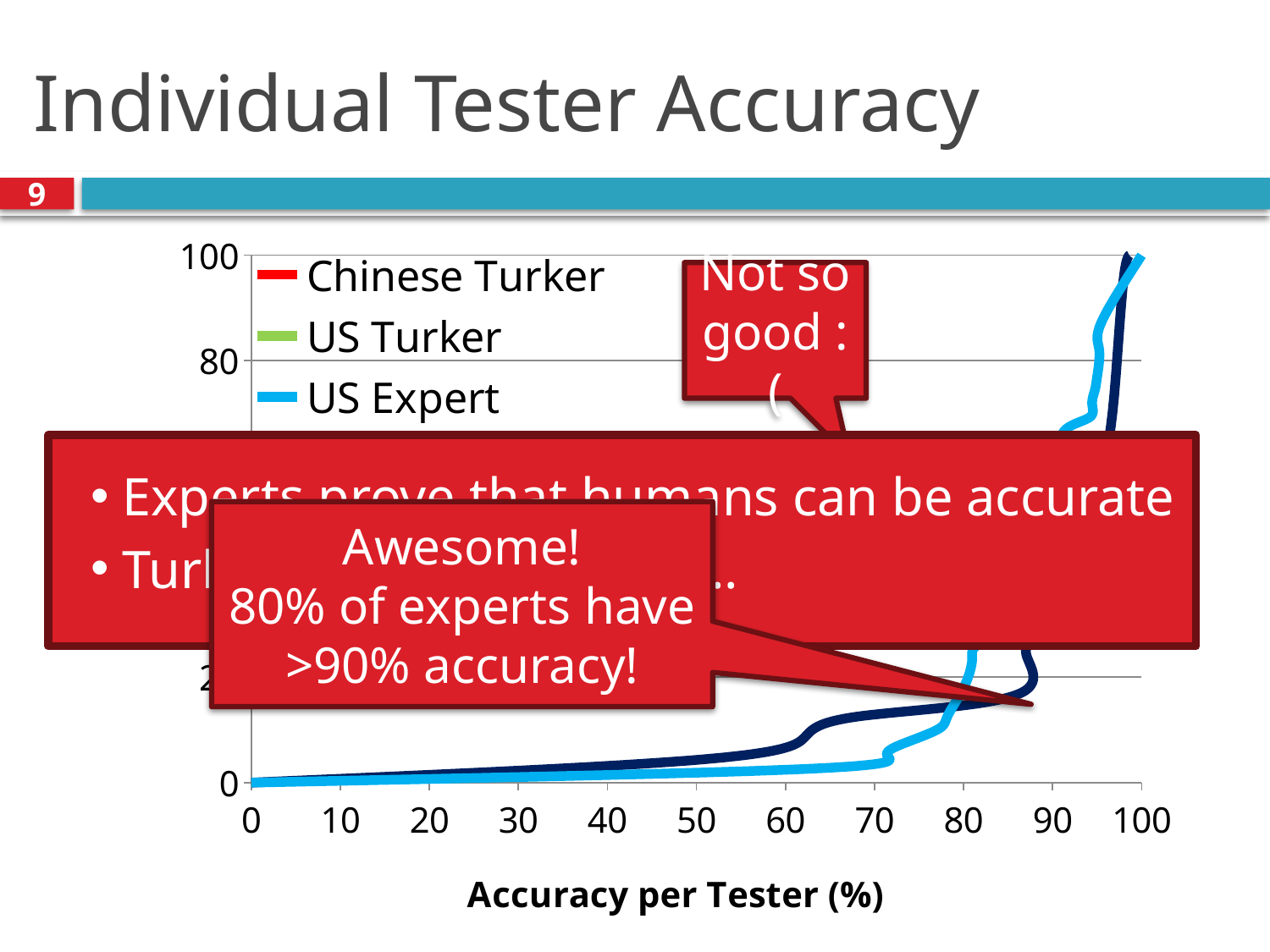
Is the value of the US Expert line at an accuracy of 70 greater or less than 80? less Which series are listed in the legend? Chinese Turker, US Turker, US Expert What is the highest value shown on the y axis? 100 What value does the US Expert line reach at an accuracy of 100? 100 What kind of chart is shown on the slide? line chart What is the highest value shown on the x axis? 100 Do the plotted lines rise or fall as the x axis increases from 0 to 100? rise How many series does the legend list? 3 What is the title of the x axis? Accuracy per Tester (%)